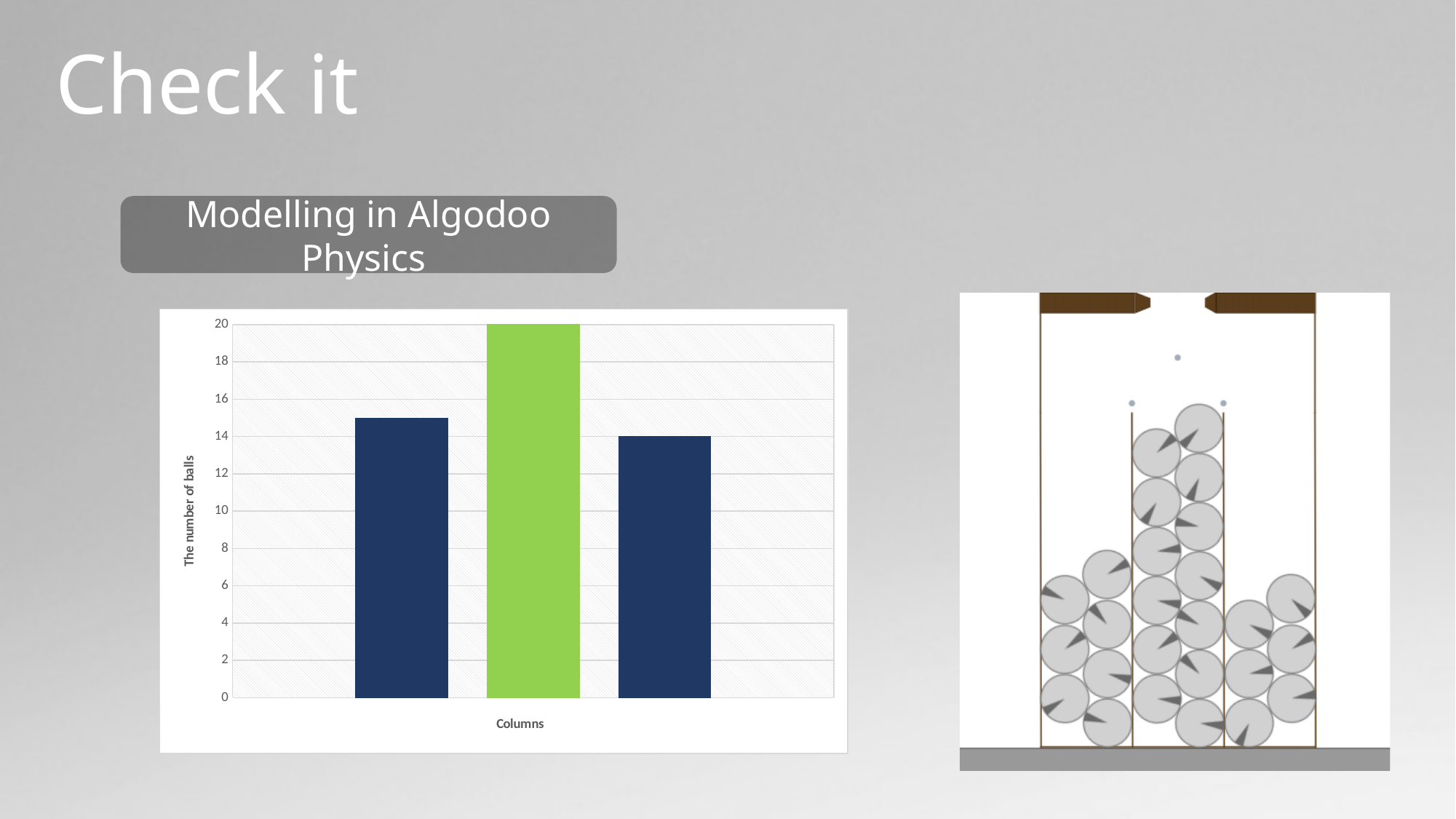
What is the title of the vertical axis of the chart? The number of balls Is the value of the leftmost bar greater or less than 16? less Which is larger, the leftmost bar or the rightmost bar? the leftmost bar What is the value of the rightmost bar? 14 Is the value of the leftmost bar greater or less than 14? greater How many bars are plotted in the chart? 3 What kind of chart is shown on the slide? bar chart Which bar in the chart is the shortest? the right bar What is the title of the horizontal axis of the chart? Columns Which bar in the chart is the tallest? the middle (green) bar